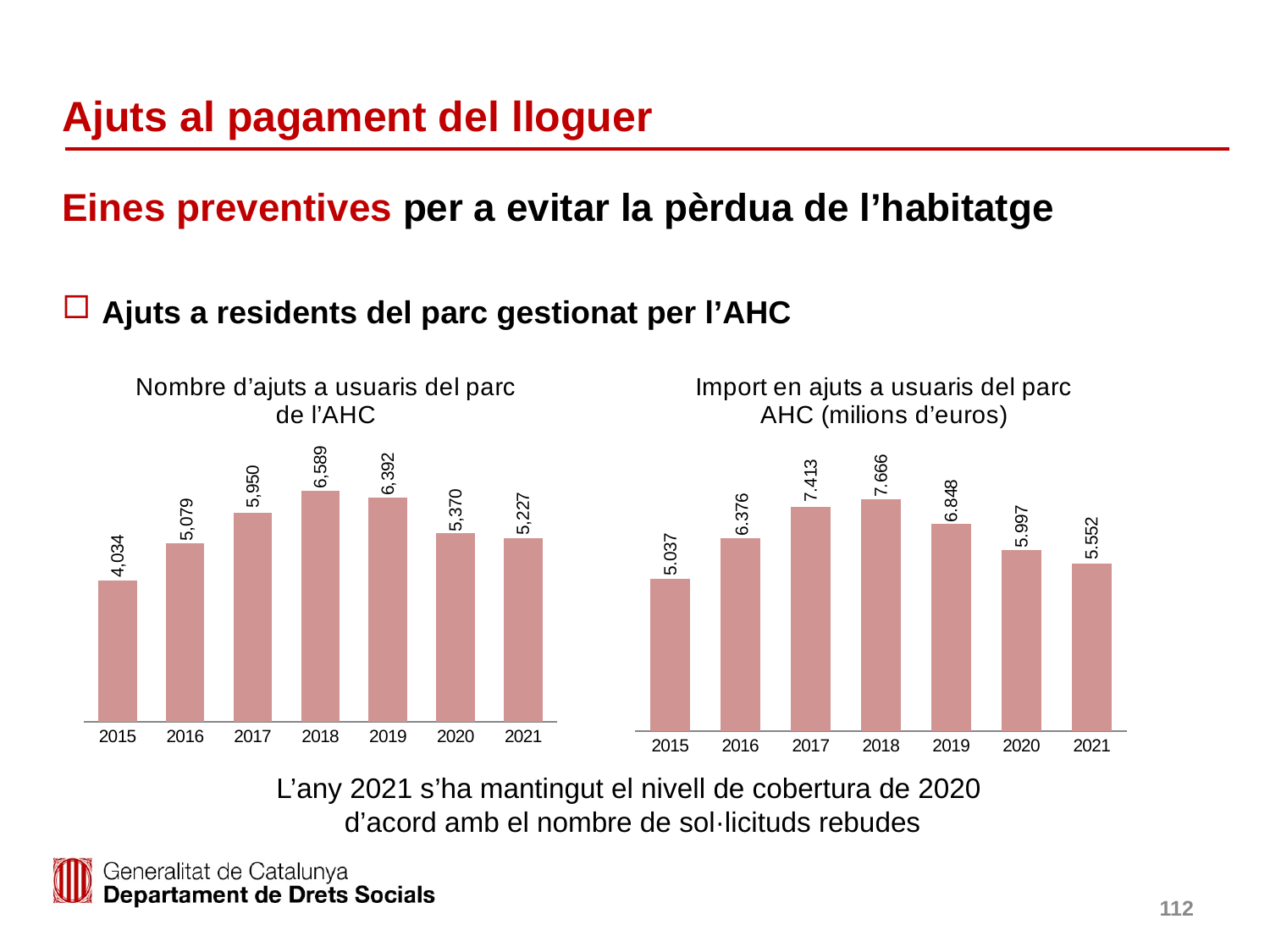
In the chart 'Import en ajuts a usuaris del parc AHC (milions d'euros)', which year has the lowest value? 2015 In the chart 'Import en ajuts a usuaris del parc AHC (milions d'euros)', which year has the larger value, 2017 or 2019? 2017 In the chart 'Nombre d'ajuts a usuaris del parc de l'AHC', what is the value for 2015? 4,034 What kind of chart is 'Import en ajuts a usuaris del parc AHC (milions d'euros)'? Bar chart What unit is given in the title of the right-hand chart? Milions d'euros In the chart 'Import en ajuts a usuaris del parc AHC (milions d'euros)', what is the value for 2019? 6.848 In the chart 'Nombre d'ajuts a usuaris del parc de l'AHC', which year has the highest value? 2018 In the chart 'Import en ajuts a usuaris del parc AHC (milions d'euros)', what is the difference between the values for 2018 and 2021? 2.114 In the chart 'Nombre d'ajuts a usuaris del parc de l'AHC', which year has the larger value, 2016 or 2020? 2020 How many years are shown in the chart 'Nombre d'ajuts a usuaris del parc de l'AHC'? 7 In the chart 'Import en ajuts a usuaris del parc AHC (milions d'euros)', do the values rise or fall from 2018 to 2021? Fall In the chart 'Nombre d'ajuts a usuaris del parc de l'AHC', what is the difference between the values for 2018 and 2015? 2,555